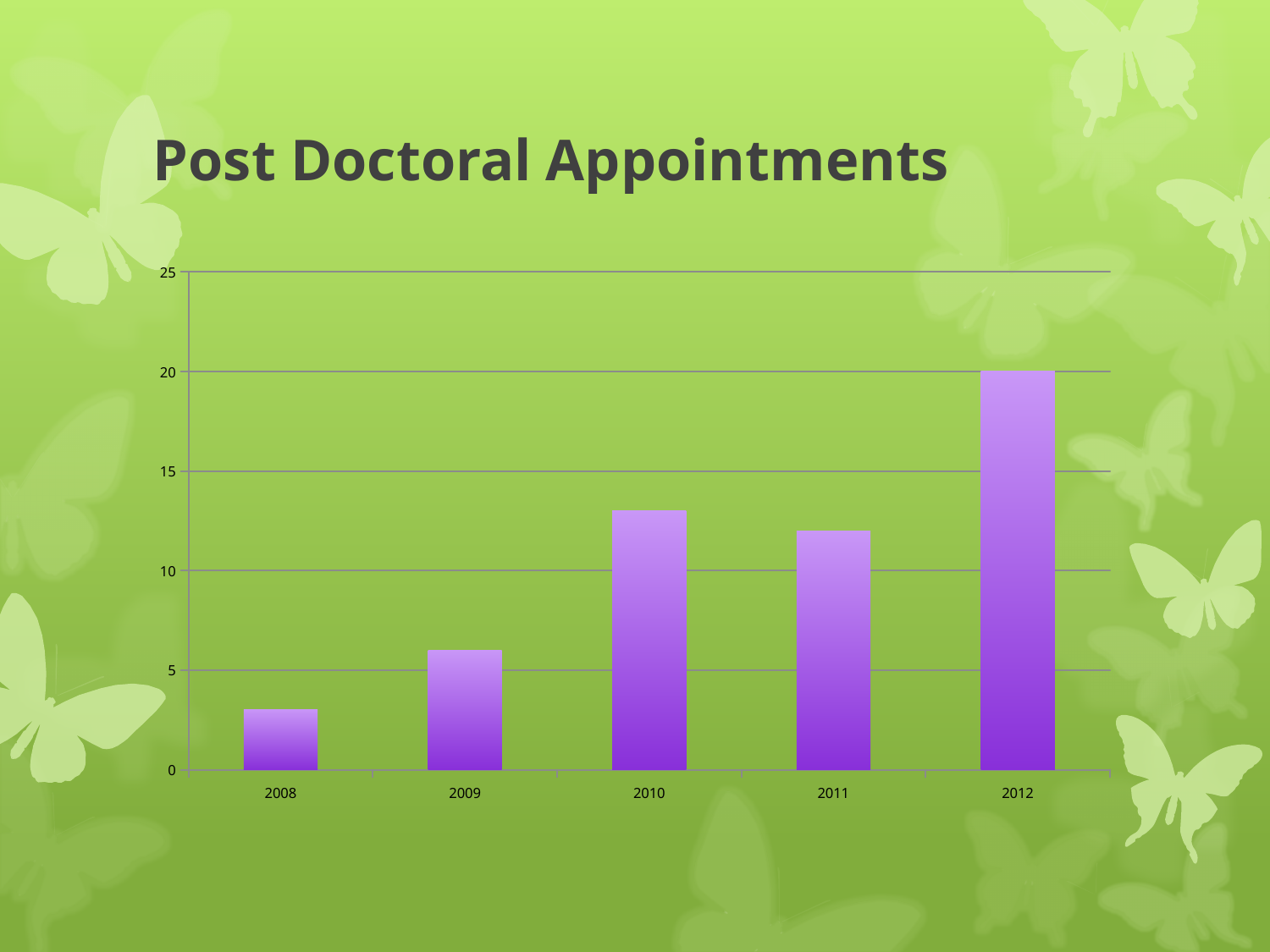
Is the value for 2010 greater or less than 15? less What kind of chart is shown on the slide? bar chart What is the title of the slide? Post Doctoral Appointments Which year has the highest number of post doctoral appointments? 2012 Is the value for 2009 greater or less than 5? greater Which year has the lowest number of post doctoral appointments? 2008 What is the value for 2012? 20 Is the value for 2008 greater or less than 5? less What is the highest value shown on the y axis? 25 How many years are shown on the x axis of the chart? 5 Which is larger, the value for 2010 or the value for 2011? 2010